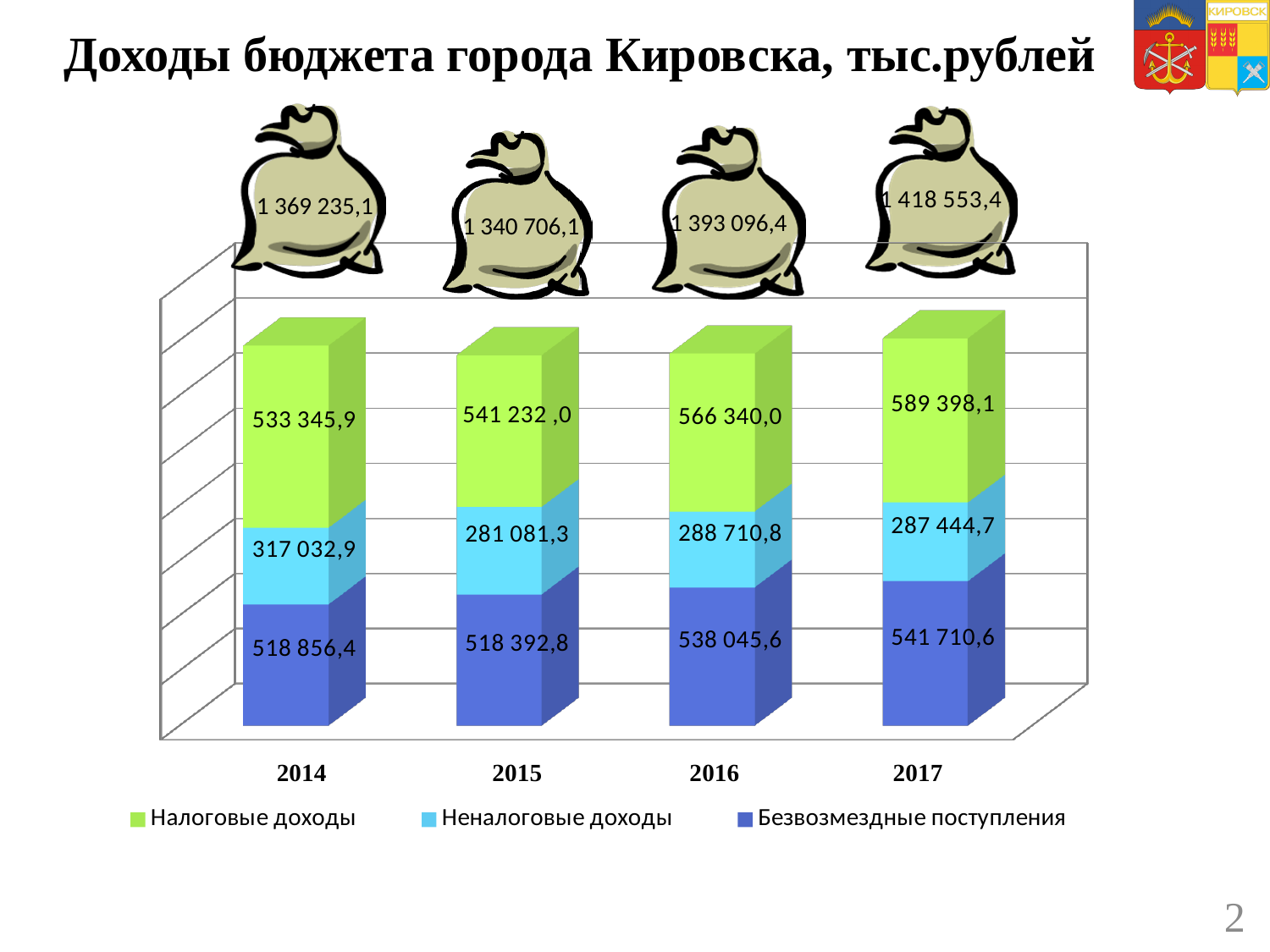
What is the value of Неналоговые доходы for 2017? 287 444,7 Do Налоговые доходы rise or fall from 2014 to 2017? rise How many years are shown on the x axis? 4 What is the difference between Налоговые доходы in 2017 and in 2014? 56 052,2 In which year are Налоговые доходы the highest? 2017 How many series does the legend list? 3 What total budget income is shown above the 2015 bar? 1 340 706,1 What total budget income is shown above the 2017 bar? 1 418 553,4 What is the value of Налоговые доходы for 2016? 566 340,0 In which year are Неналоговые доходы the lowest? 2015 Which is larger in 2016: Налоговые доходы or Безвозмездные поступления? Налоговые доходы What is the value of Безвозмездные поступления for 2015? 518 392,8